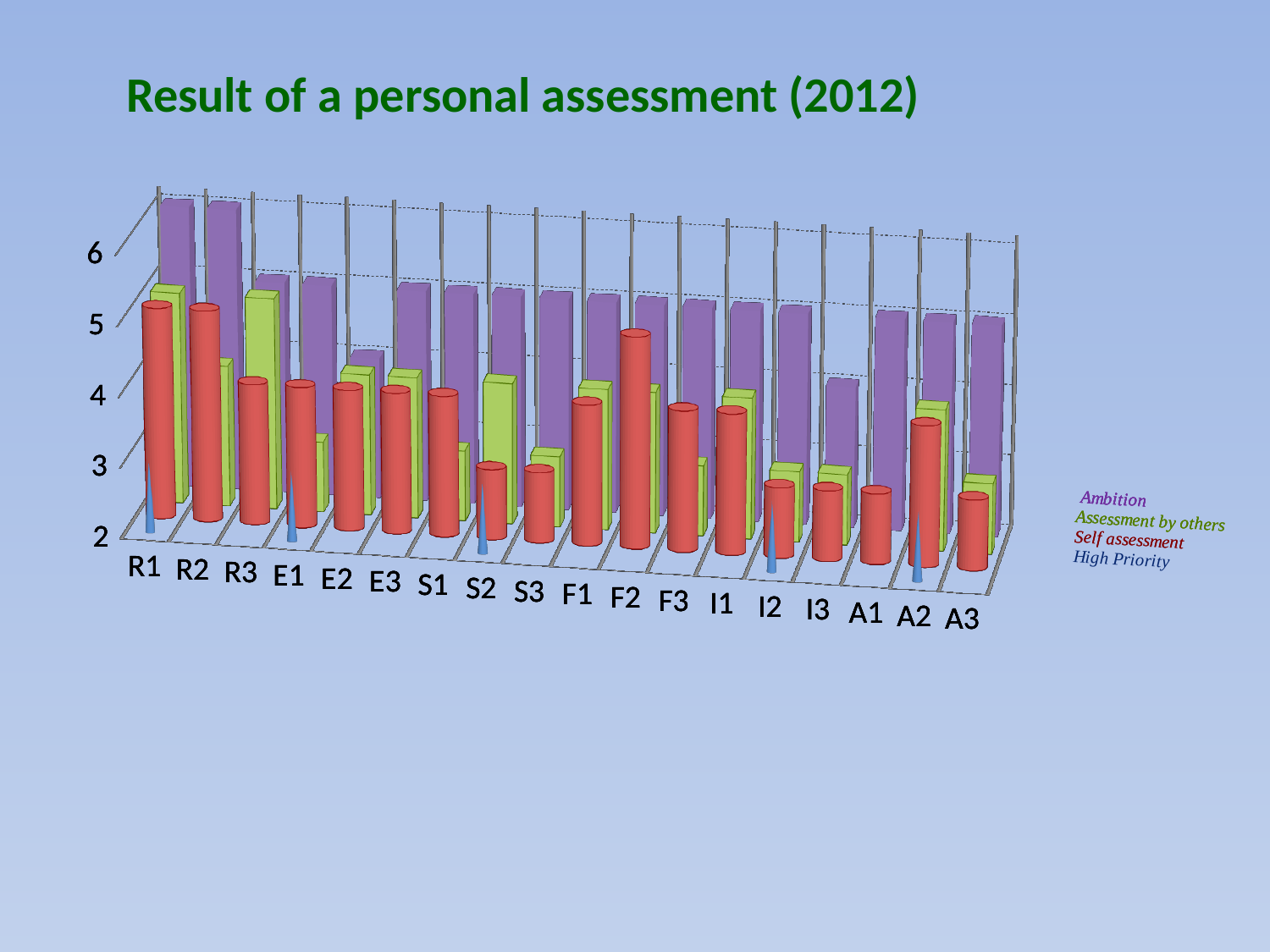
Which is larger, the Ambition value for R1 or for E1? R1 Which is larger, the Self assessment value for F2 or for F3? F2 Which is larger, the Assessment by others value for R1 or for I2? R1 Which colour represents the Self assessment series in the chart? red Is the Self assessment value for F2 greater or less than 4? greater What is the title of the chart? Result of a personal assessment (2012) How many series does the chart's legend list? 4 How many categories are shown along the x axis of the chart? 18 Is the Self assessment value for R1 greater or less than 4? greater What kind of chart is shown on the slide? bar chart